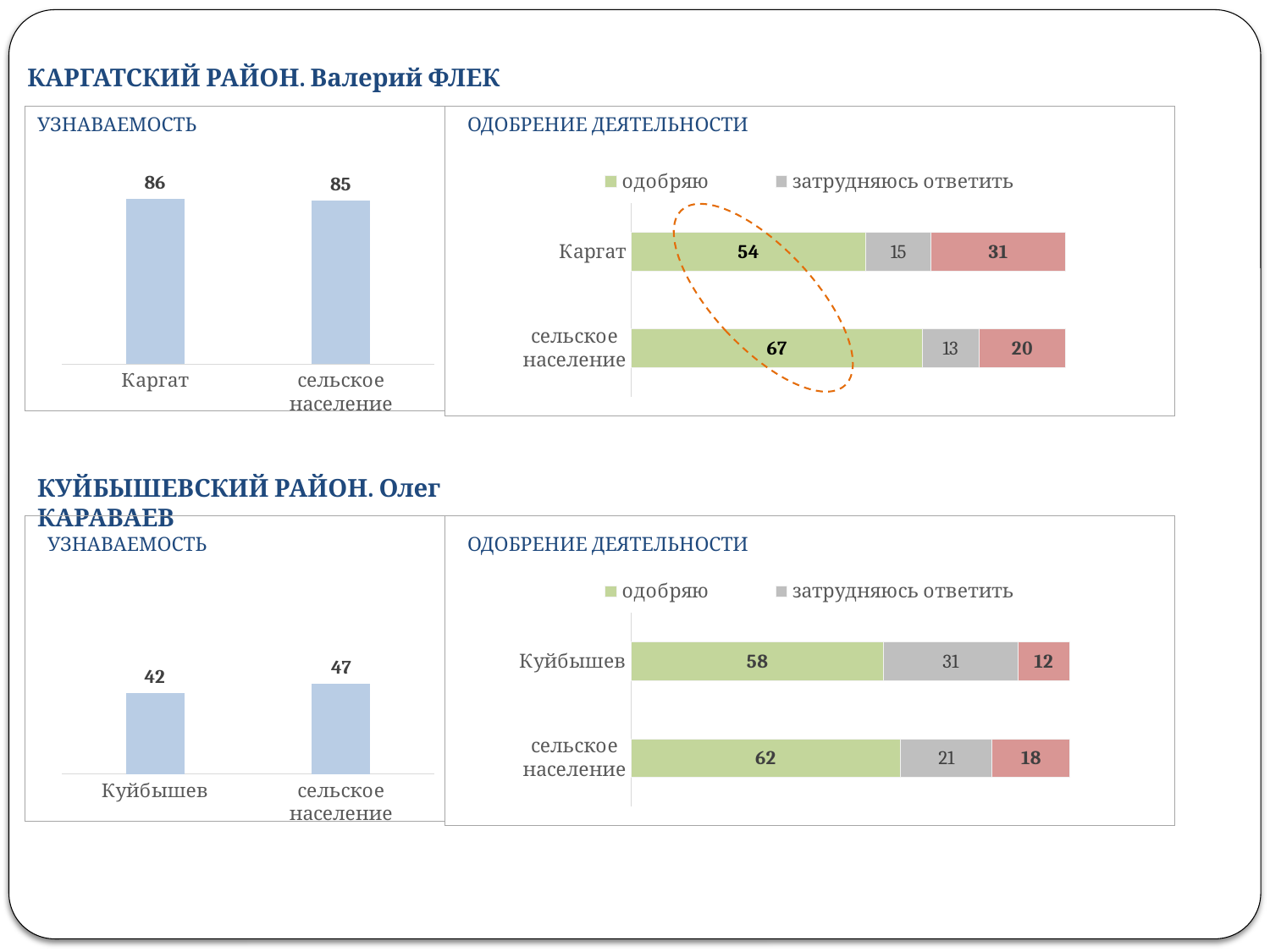
In the bottom-left chart (УЗНАВАЕМОСТЬ for Куйбышевский район), what is the value for Куйбышев? 42 In the top-left chart (УЗНАВАЕМОСТЬ for Каргатский район), what is the value for сельское население? 85 What kind of chart is the top-left chart (УЗНАВАЕМОСТЬ for Каргатский район)? bar chart In the top-right chart (ОДОБРЕНИЕ ДЕЯТЕЛЬНОСТИ for Каргатский район), what is the одобряю value for сельское население? 67 In the bottom-right chart (ОДОБРЕНИЕ ДЕЯТЕЛЬНОСТИ for Куйбышевский район), which is larger: the одобряю value for Куйбышев or for сельское население? сельское население In the bottom-left chart (УЗНАВАЕМОСТЬ for Куйбышевский район), which category has the higher value? сельское население In the bottom-right chart (ОДОБРЕНИЕ ДЕЯТЕЛЬНОСТИ for Куйбышевский район), what is the затрудняюсь ответить value for Куйбышев? 31 In the top-left chart (УЗНАВАЕМОСТЬ for Каргатский район), what is the value for Каргат? 86 In the bottom-right chart (ОДОБРЕНИЕ ДЕЯТЕЛЬНОСТИ for Куйбышевский район), what is the total of the stacked bar for сельское население? 101 In the top-right chart (ОДОБРЕНИЕ ДЕЯТЕЛЬНОСТИ for Каргатский район), what is the total of the stacked bar for Каргат? 100 In the top-right chart (ОДОБРЕНИЕ ДЕЯТЕЛЬНОСТИ for Каргатский район), what is the затрудняюсь ответить value for Каргат? 15 In the top-right chart (ОДОБРЕНИЕ ДЕЯТЕЛЬНОСТИ for Каргатский район), what is the difference between the одобряю values for сельское население and Каргат? 13